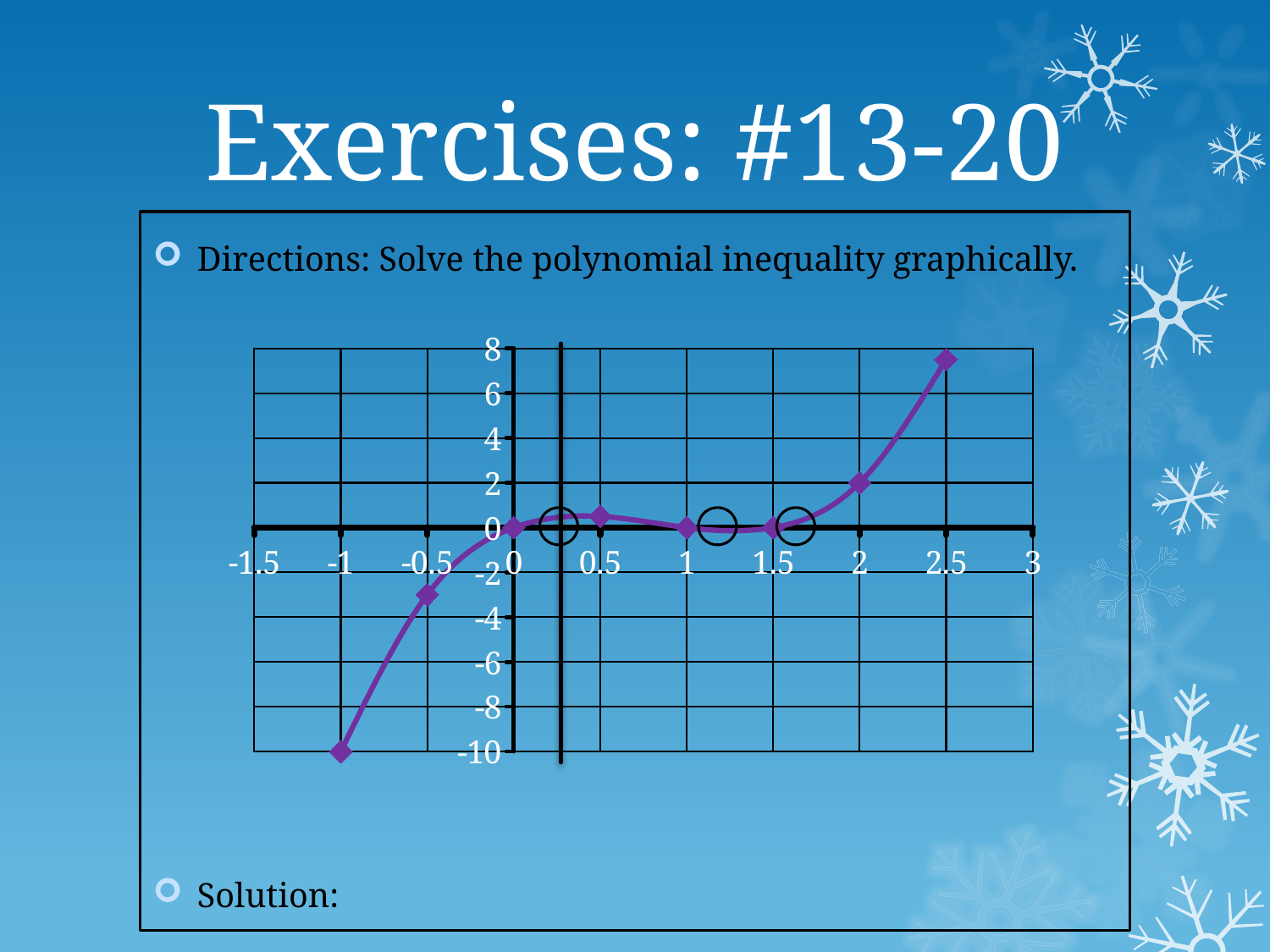
At which plotted x value is the curve lowest? -1 What is the value of the curve at x = 2? 2 Which is larger, the value of the curve at x = 2 or at x = -0.5? x = 2 Is the value of the curve at x = 2.5 greater or less than 6? greater At which plotted x value is the curve highest? 2.5 What is the lowest value shown on the vertical axis? -10 What kind of chart is shown on the slide? line chart Overall, does the curve rise or fall as x increases from -1 to 2.5? rise What is the value of the curve at x = -1? -10 What is the value of the curve at x = 1? 0 Is the value of the curve at x = -0.5 greater or less than -2? less How many data points are plotted on the curve? 8